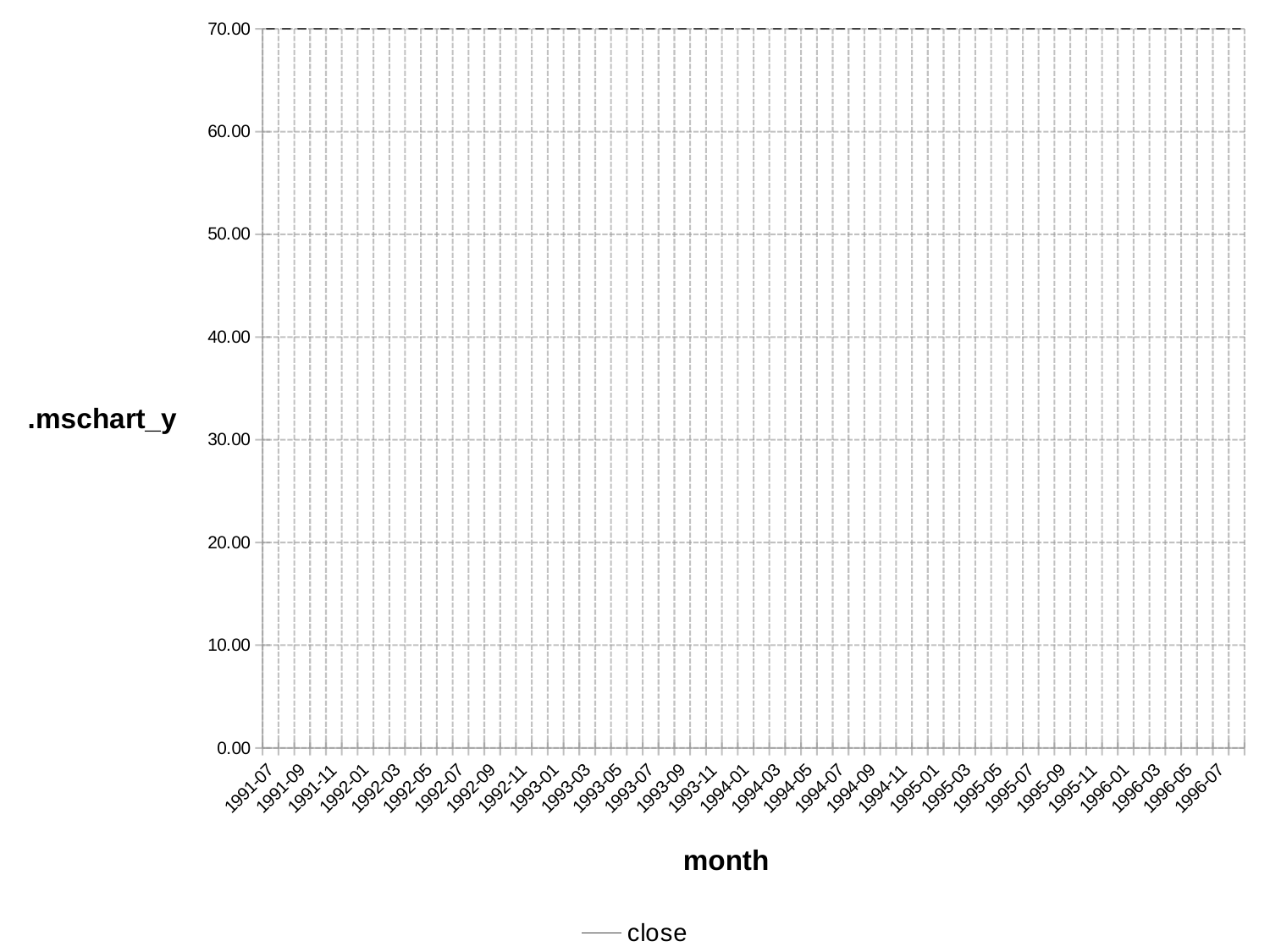
How many series does the legend list? 1 What is the name of the series shown in the legend? close What is the highest value shown on the y axis? 70.00 What is the title of the x axis? month